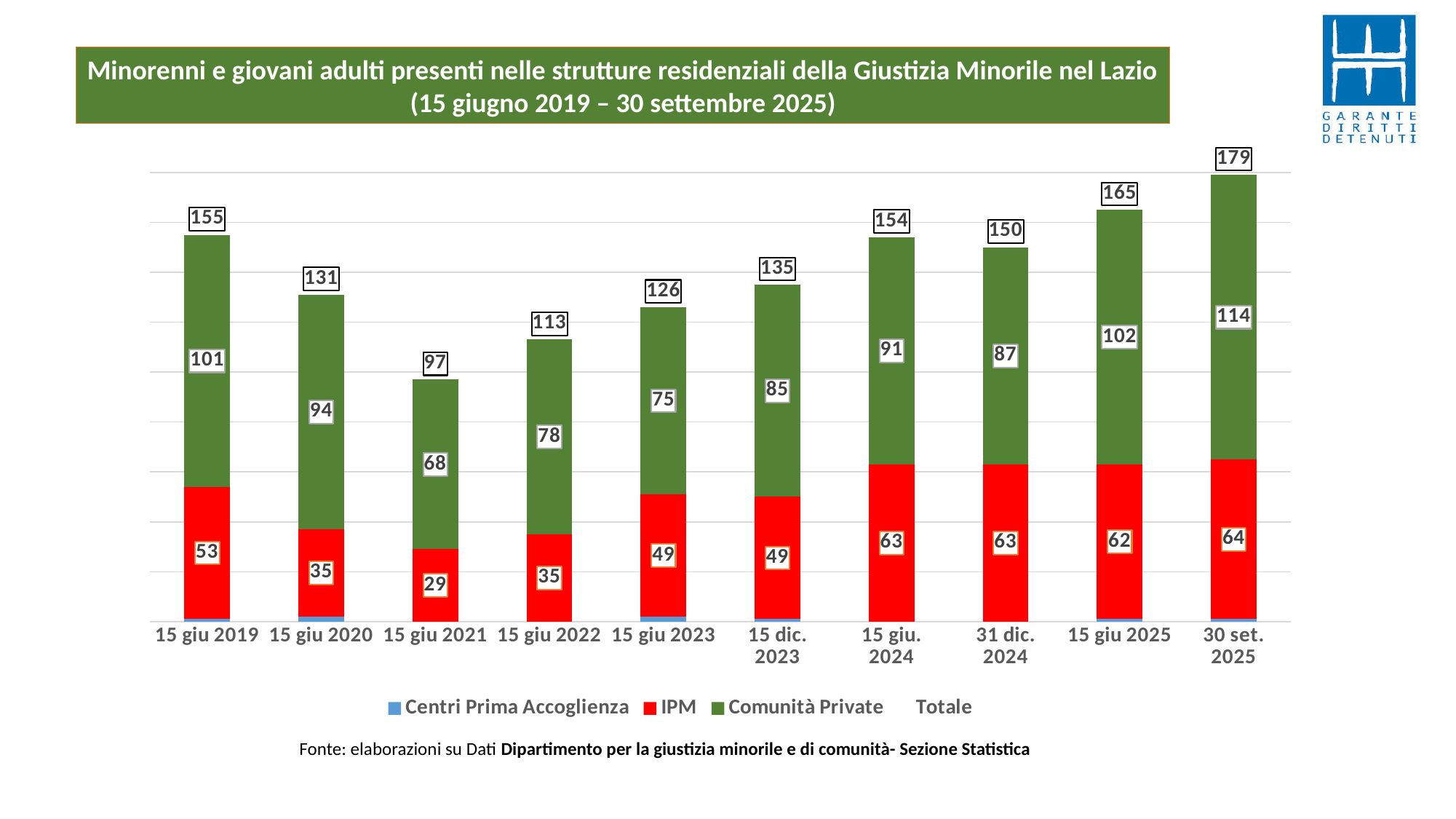
What is the difference between the total for 30 set. 2025 and the total for 15 giu 2025? 14 What kind of chart is shown on the slide? Stacked bar chart What is the IPM value for 15 giu 2019? 53 How many dates (categories) are shown on the x axis? 10 Which date has the highest total value? 30 set. 2025 Do the total values rise or fall from 15 giu 2021 to 30 set. 2025? Rise Which is larger, the Comunità Private value for 15 giu 2020 or for 15 giu 2022? 15 giu 2020 What is the total (Totale) value for 30 set. 2025? 179 How many series does the legend list? 4 Which colour represents the IPM series in the chart? Red What is the Comunità Private value for 15 giu 2021? 68 Which date has the lowest total value? 15 giu 2021